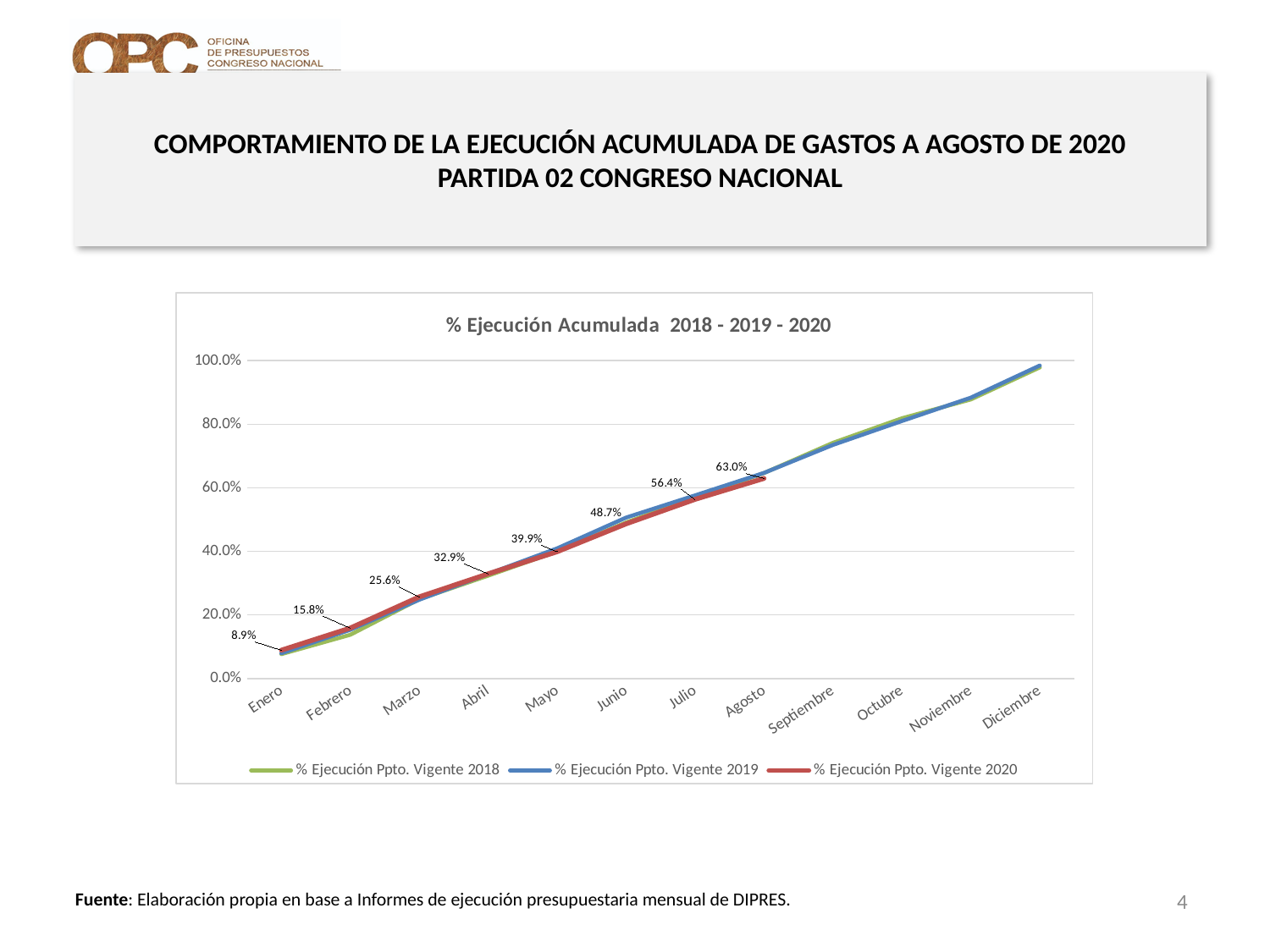
What type of chart is shown on the slide? line chart Is the value for % Ejecución Ppto. Vigente 2019 in Diciembre greater or less than 80.0%? greater How many months are shown on the x axis? 12 What is the title of the chart? % Ejecución Acumulada 2018 - 2019 - 2020 What is the value for % Ejecución Ppto. Vigente 2020 in Agosto? 63.0% What is the value for % Ejecución Ppto. Vigente 2020 in Julio? 56.4% What is the value for % Ejecución Ppto. Vigente 2020 in Mayo? 39.9% What is the difference between the 2020 values for Marzo and Febrero? 9.8% What is the value for % Ejecución Ppto. Vigente 2020 in Enero? 8.9% How many series does the legend list? 3 What is the difference between the 2020 values for Agosto and Julio? 6.6% Do the values for % Ejecución Ppto. Vigente 2020 rise or fall from Enero to Agosto? rise